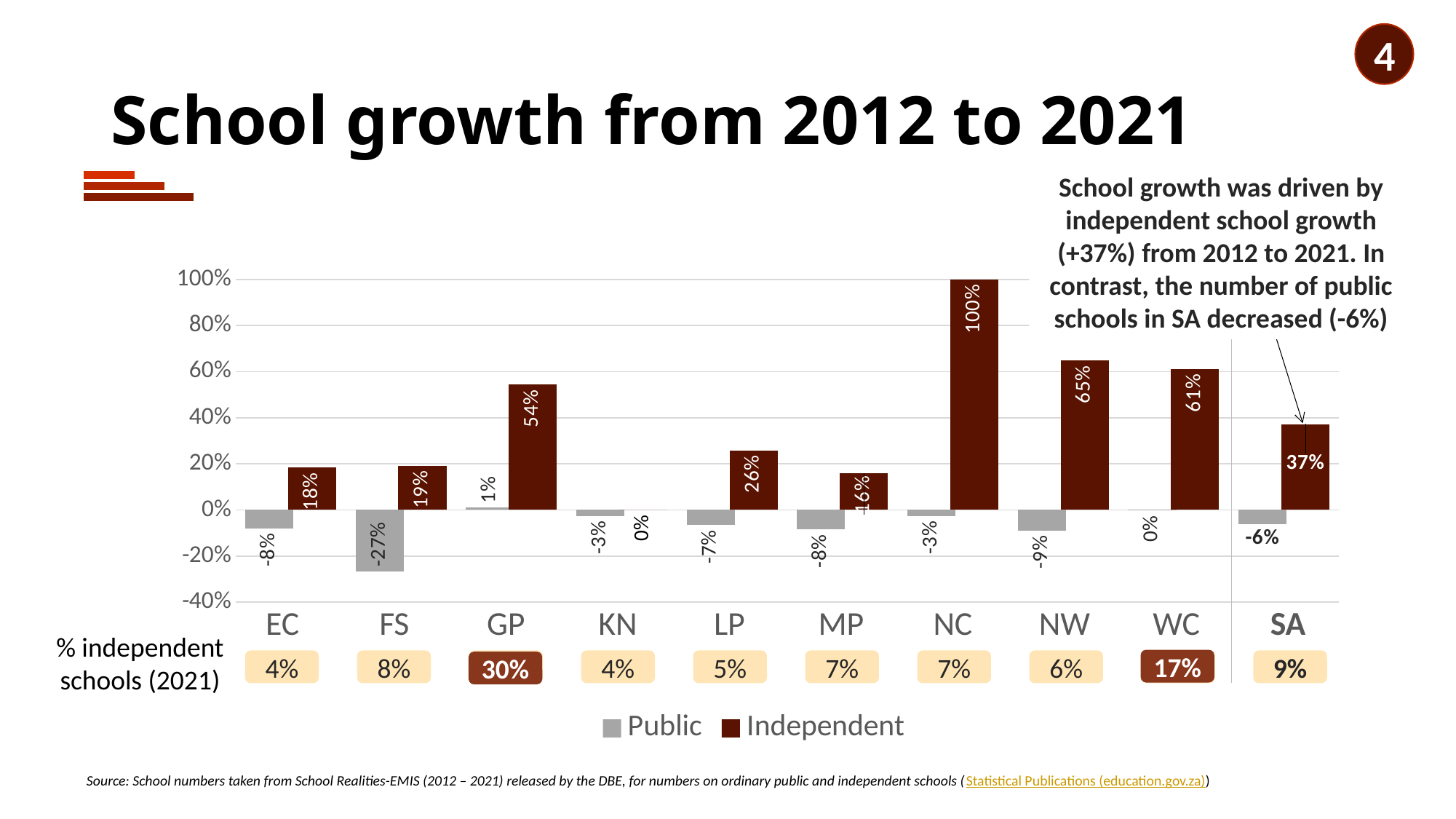
What is the difference between the Independent and Public growth values for GP? 53% What is the Public school growth value for FS? -27% How many categories are shown on the x axis? 10 What colour are the Independent bars in the chart? Dark red What is the Independent school growth value for SA? 37% What is the Public school growth value for KN? -3% What is the Independent school growth value for NC? 100% Which province has the highest Independent school growth? NC What kind of chart is shown on the slide? Bar chart Which province has the lowest Public school growth? FS Which is larger, the Independent growth for NW or for WC? NW How many series does the legend list? 2